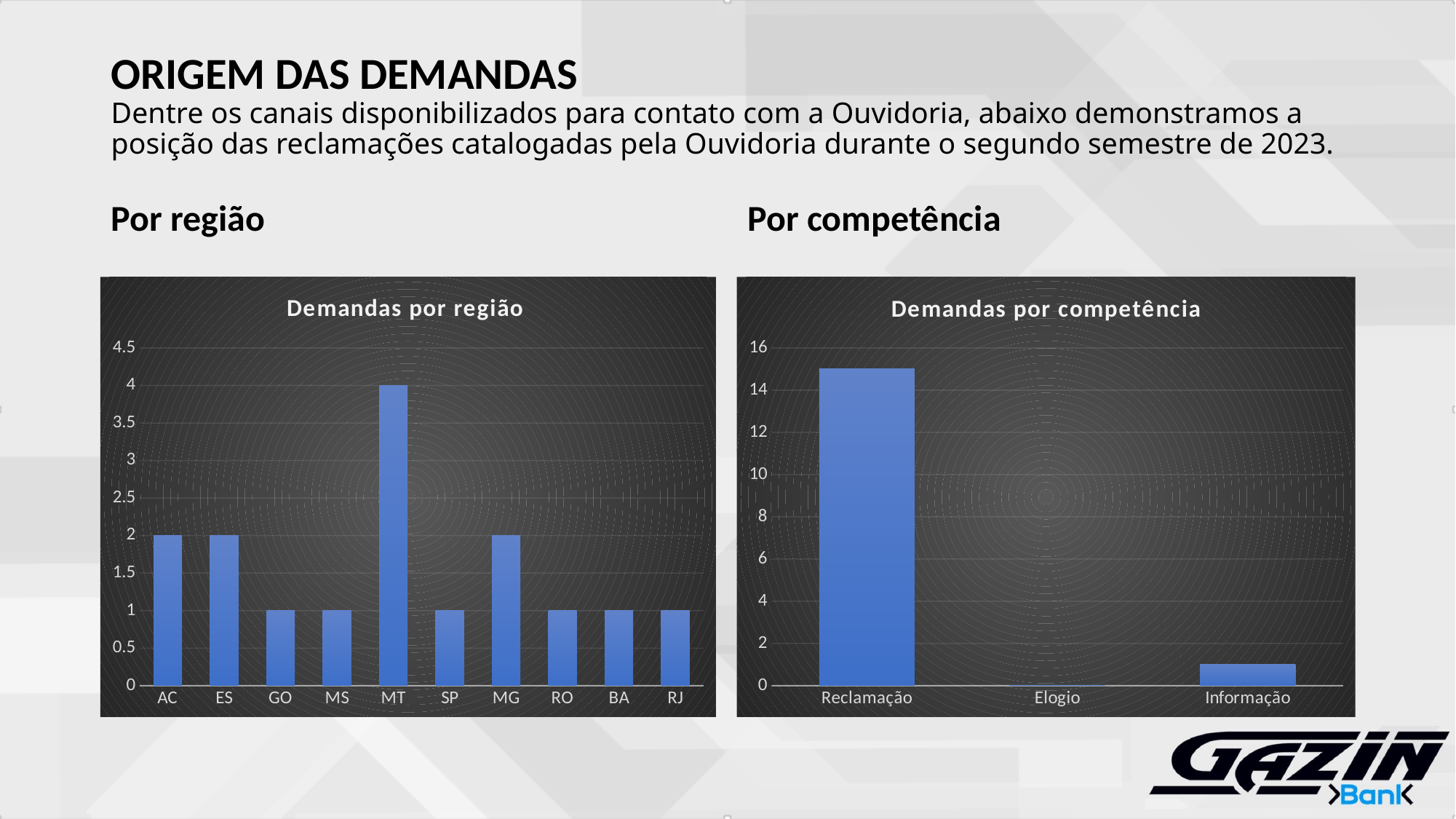
In the 'Demandas por competência' chart, how many categories are shown on the x axis? 3 In the 'Demandas por região' chart, what is the value for MT? 4 In the 'Demandas por competência' chart, is the value for Informação greater or less than 2? less In the 'Demandas por competência' chart, which category has the highest value? Reclamação In the 'Demandas por região' chart, how many regions are shown on the x axis? 10 What is the title of the chart on the right side of the slide? Demandas por competência In the 'Demandas por região' chart, which region has the highest value? MT In the 'Demandas por região' chart, what is the difference between the values for MT and GO? 3 In the 'Demandas por região' chart, which is larger, the value for ES or the value for MS? ES What kind of chart is the 'Demandas por região' chart? bar chart In the 'Demandas por competência' chart, is the value for Reclamação greater or less than 14? greater In the 'Demandas por região' chart, what is the value for AC? 2